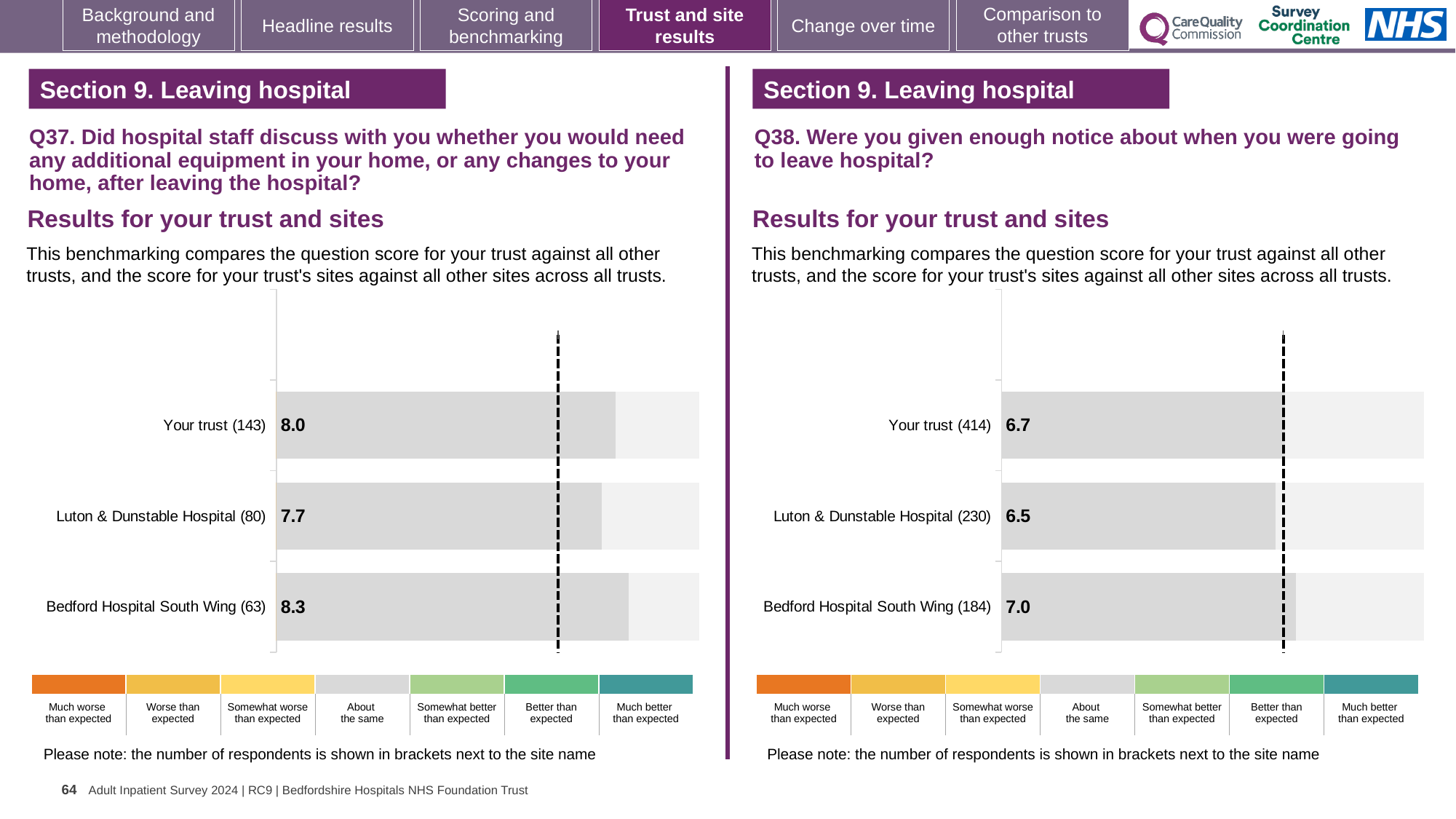
In the Q38 chart on the right, which is larger: the score for Your trust (414) or for Luton & Dunstable Hospital (230)? Your trust (414) In the Q37 chart on the left, what is the score for Your trust (143)? 8.0 In the Q38 chart on the right, how many respondents are shown in brackets for Luton & Dunstable Hospital? 230 What kind of chart is used in the Q37 chart on the left? Bar chart In the Q37 chart on the left, how many bars are plotted? 3 In the Q37 chart on the left, which site or trust has the highest score? Bedford Hospital South Wing (63) In the Q37 chart on the left, what is the score for Luton & Dunstable Hospital (80)? 7.7 In the Q38 chart on the right, which site or trust has the lowest score? Luton & Dunstable Hospital (230) In the Q37 chart on the left, what is the difference between the scores for Bedford Hospital South Wing (63) and Luton & Dunstable Hospital (80)? 0.6 In the Q38 chart on the right, what is the difference between the scores for Bedford Hospital South Wing (184) and Your trust (414)? 0.3 In the Q38 chart on the right, what is the score for Bedford Hospital South Wing (184)? 7.0 In the Q38 chart on the right, what is the score for Your trust (414)? 6.7